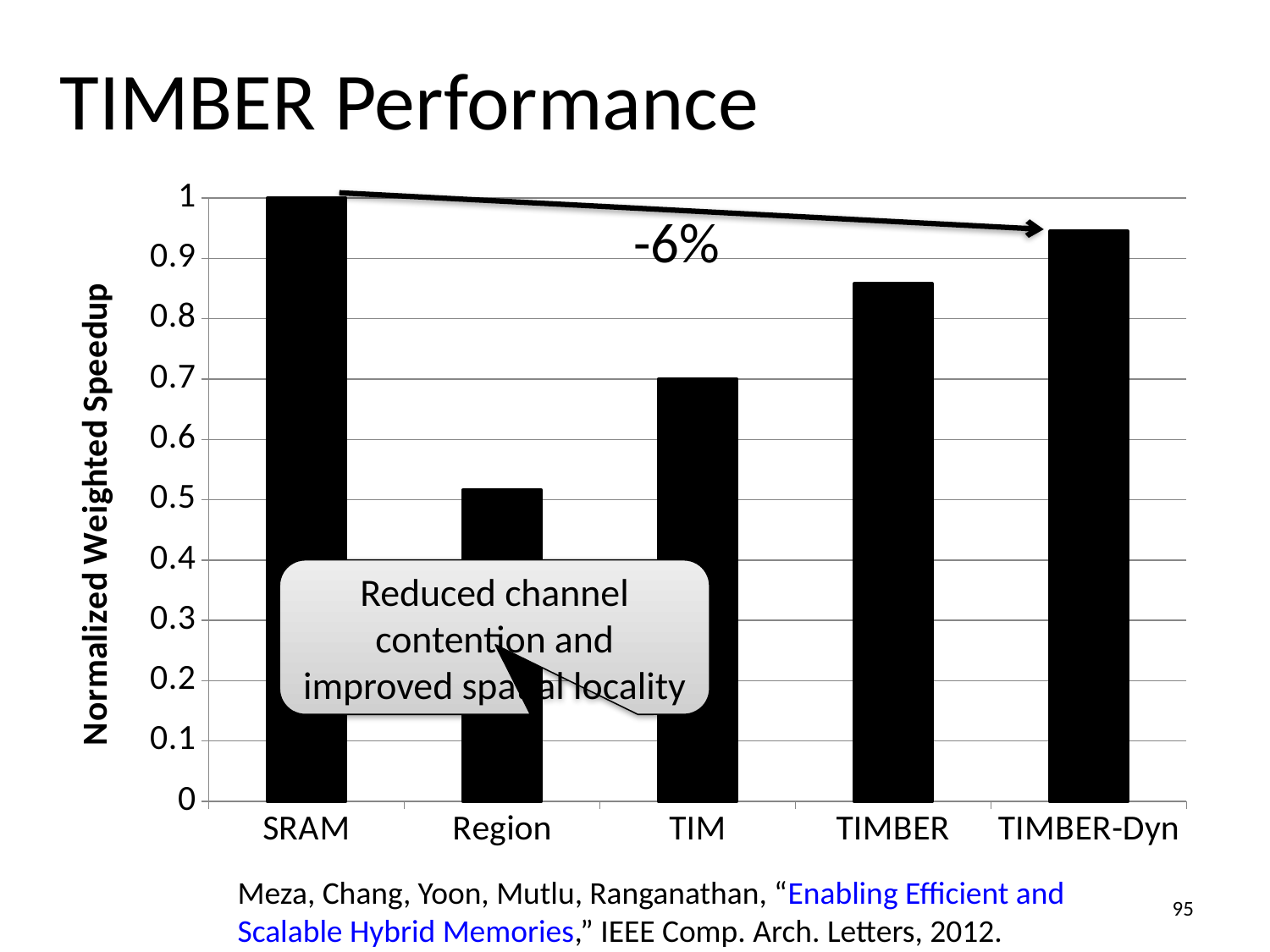
Is the value for TIMBER greater or less than 0.8? greater What is the label on the y axis of the chart? Normalized Weighted Speedup Is the value for Region greater or less than 0.6? less What is the normalized weighted speedup for SRAM? 1 Which has a higher normalized weighted speedup, TIM or TIMBER? TIMBER Which category has the lowest normalized weighted speedup? Region Which category has the highest normalized weighted speedup? SRAM Is the value for TIMBER-Dyn greater or less than 0.9? greater What kind of chart is shown on the slide? bar chart How many categories are shown on the x axis of the chart? 5 Which has a higher normalized weighted speedup, Region or TIM? TIM